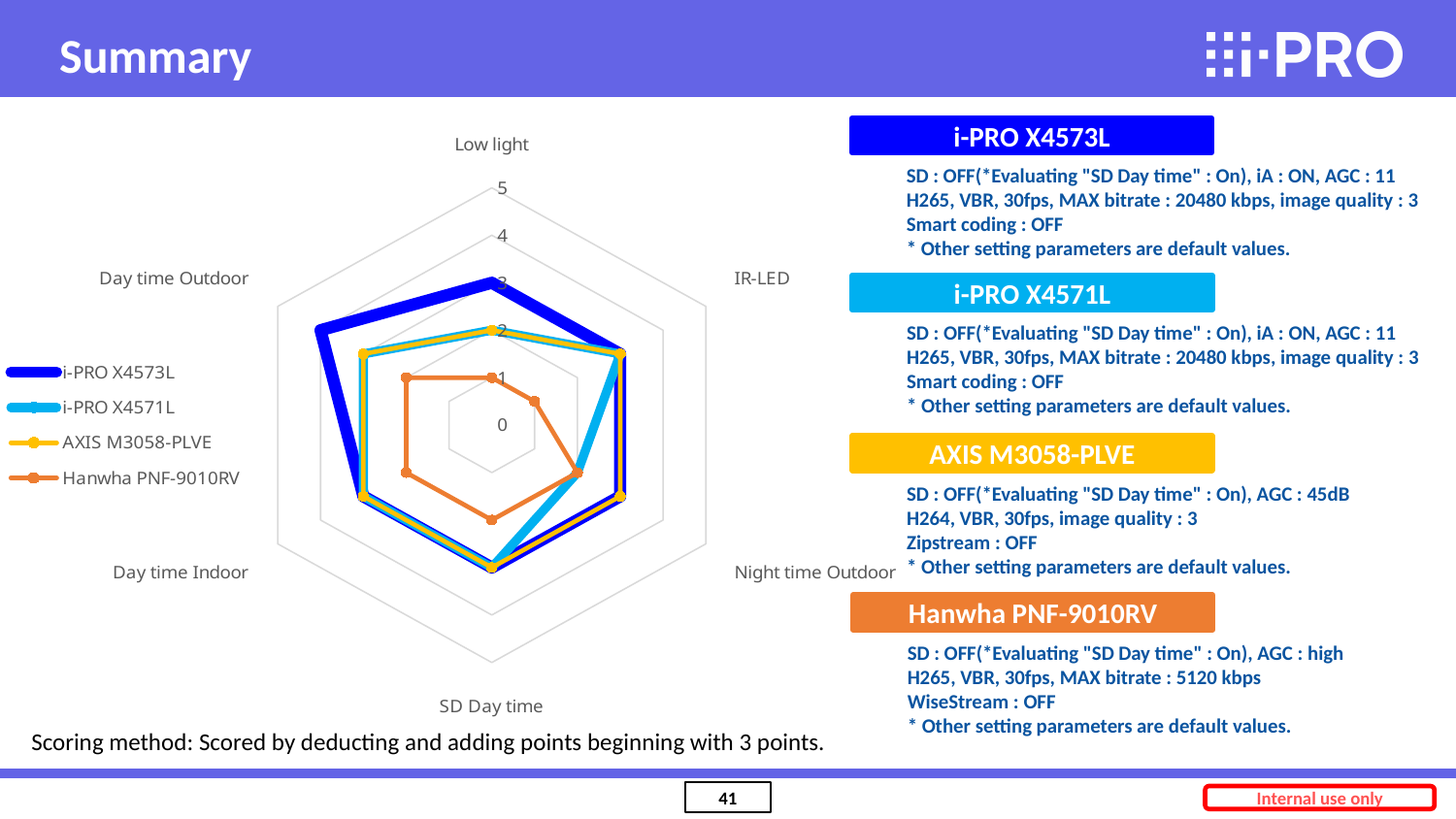
What is the maximum value shown on the chart's scale? 5 What is the Day time Outdoor score for i-PRO X4573L? 4 What is the Low light score for i-PRO X4573L? 3 Which series has the highest Low light score? i-PRO X4573L Which series has the lowest IR-LED score? Hanwha PNF-9010RV Which is larger, the Day time Outdoor score for i-PRO X4573L or for Hanwha PNF-9010RV? i-PRO X4573L How many series does the chart legend list? 4 How many categories (axes) does the radar chart have? 6 Is the IR-LED score for Hanwha PNF-9010RV greater or less than 2? less What kind of chart is shown on the slide? Radar chart What is the Low light score for Hanwha PNF-9010RV? 1